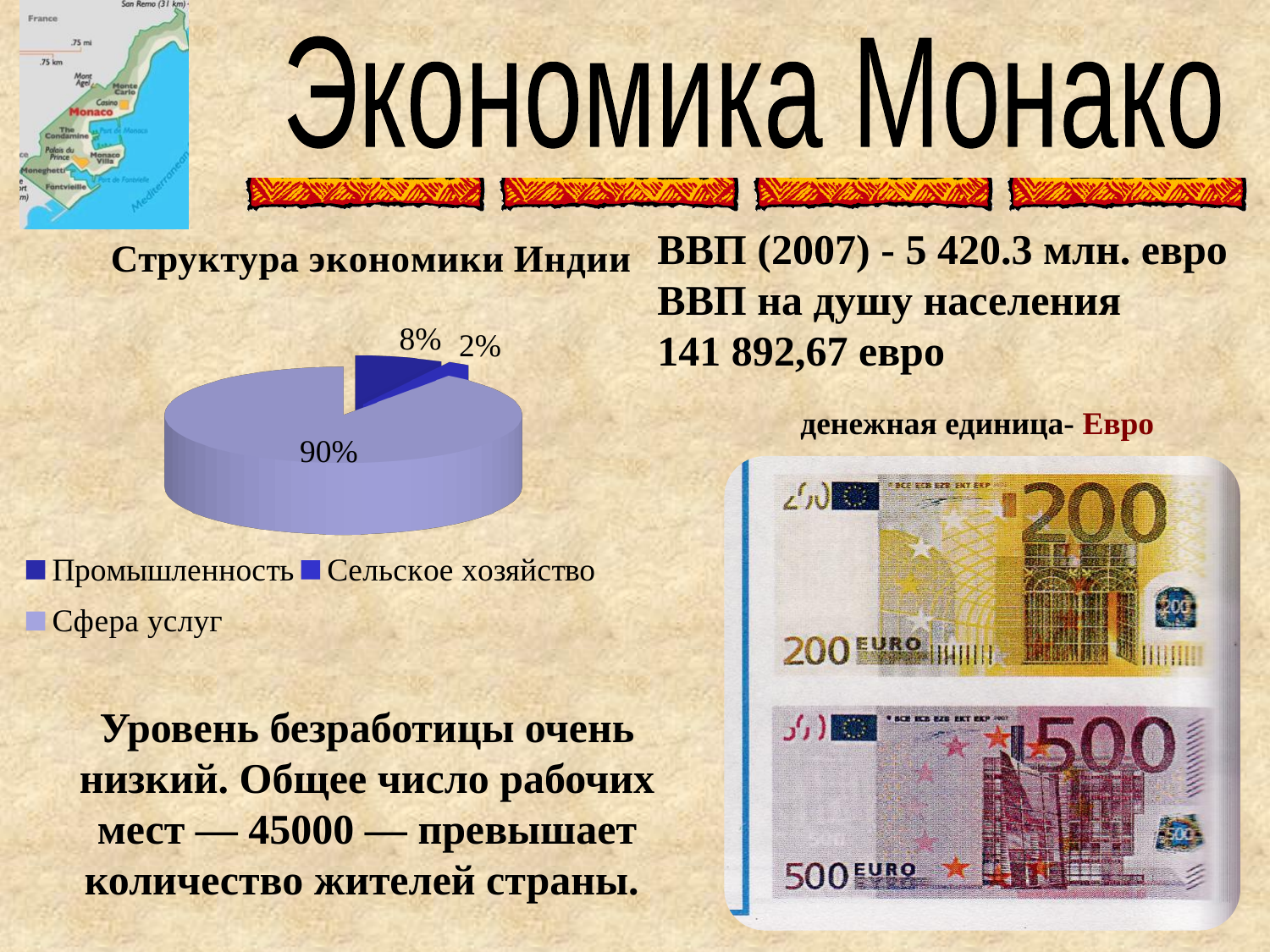
Which category has the largest slice in the pie chart? Сфера услуг What share of the pie does Сфера услуг have? 90% What share of the pie does Промышленность have? 8% What is the title of the pie chart? Структура экономики Индии What type of chart is shown on the slide? pie chart Which legend entry is shown in the lightest colour? Сфера услуг What share of the pie does Сельское хозяйство have? 2% How many slices does the pie chart have? 3 What is the difference in percentage points between Сфера услуг and Промышленность? 82 How many entries does the legend of the pie chart list? 3 Which is larger in the pie chart, Промышленность or Сельское хозяйство? Промышленность Which category has the smallest slice in the pie chart? Сельское хозяйство